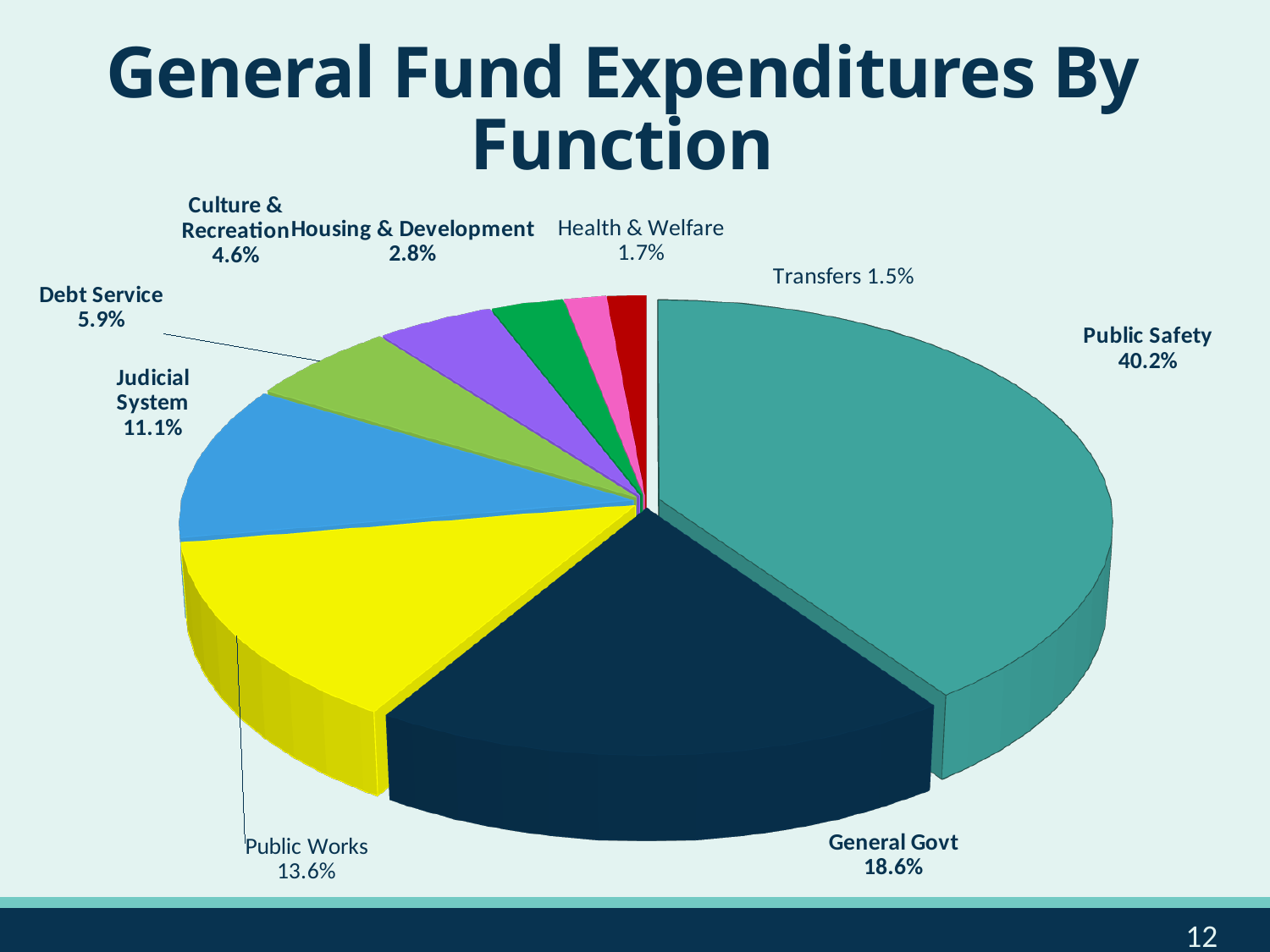
What is the difference in percentage points between Public Works and Judicial System? 2.5 What share of General Fund expenditures goes to Public Safety? 40.2% What is the value shown for Judicial System? 11.1% What is the difference in percentage points between Public Safety and General Govt? 21.6 Which function has the smallest share of General Fund expenditures? Transfers How many slices does the pie chart have? 9 Which function has the largest share of General Fund expenditures? Public Safety Which is larger, Debt Service or Culture & Recreation? Debt Service What percentage is shown for Transfers? 1.5% What kind of chart is shown on the slide? Pie chart What percentage of the pie is General Govt? 18.6% What is the title of the chart? General Fund Expenditures By Function